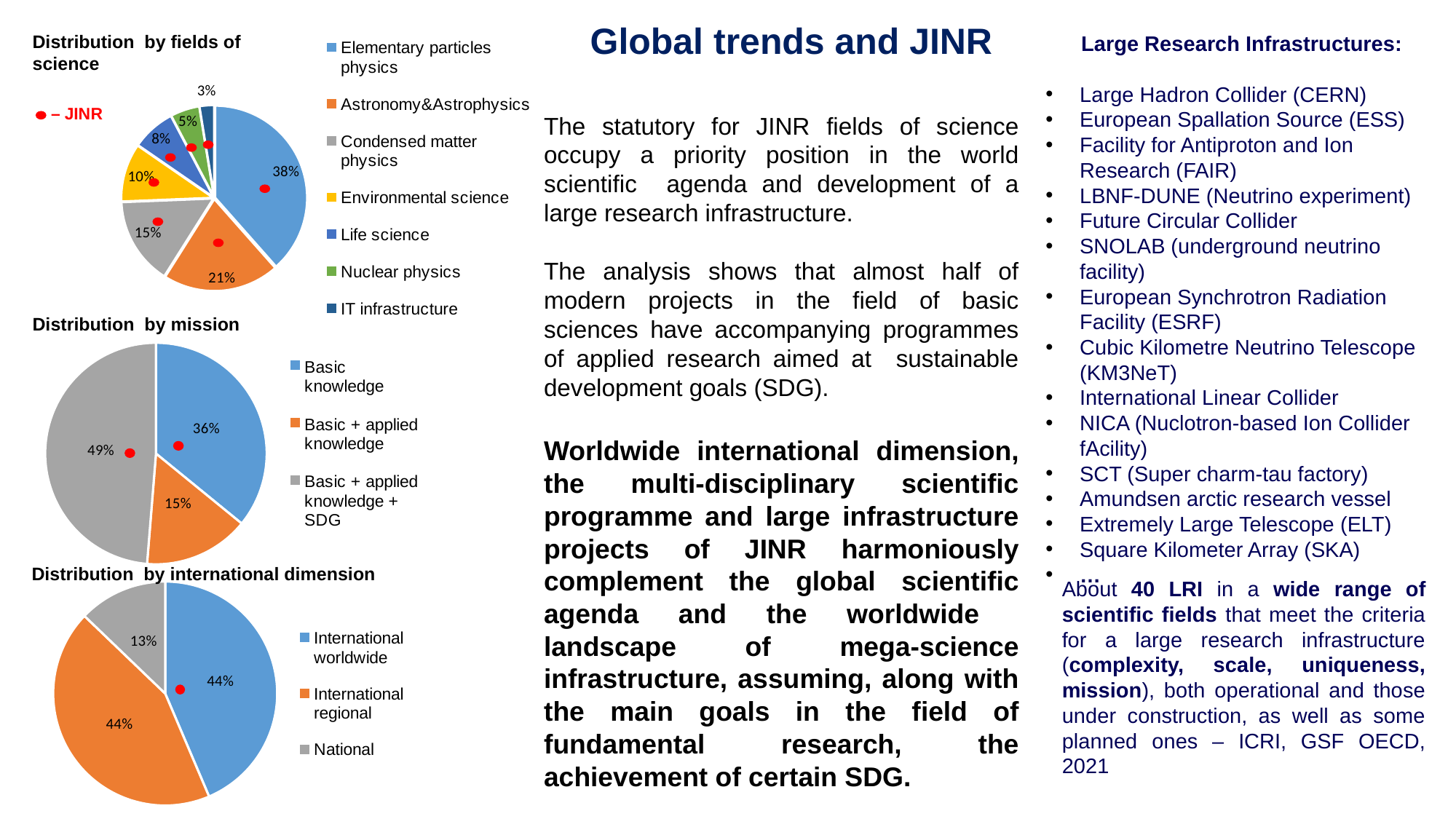
In the 'Distribution by fields of science' pie chart, what share is Elementary particles physics? 38% In the 'Distribution by fields of science' pie chart, what is the difference between the shares of Astronomy&Astrophysics and Condensed matter physics? 6% In the 'Distribution by international dimension' pie chart, what share is National? 13% In the 'Distribution by fields of science' pie chart, how many fields of science are shown? 7 In the 'Distribution by international dimension' pie chart, what share is International regional? 44% In the 'Distribution by mission' pie chart, how many categories does the legend list? 3 In the 'Distribution by fields of science' pie chart, which field has the smallest share? IT infrastructure In the 'Distribution by mission' pie chart, which is larger: Basic knowledge or Basic + applied knowledge? Basic knowledge What type of chart is used for 'Distribution by international dimension'? Pie chart In the 'Distribution by mission' pie chart, what share is Basic + applied knowledge + SDG? 49% In the 'Distribution by fields of science' pie chart, which field has the largest share? Elementary particles physics In the 'Distribution by fields of science' pie chart, what share is Environmental science? 10%